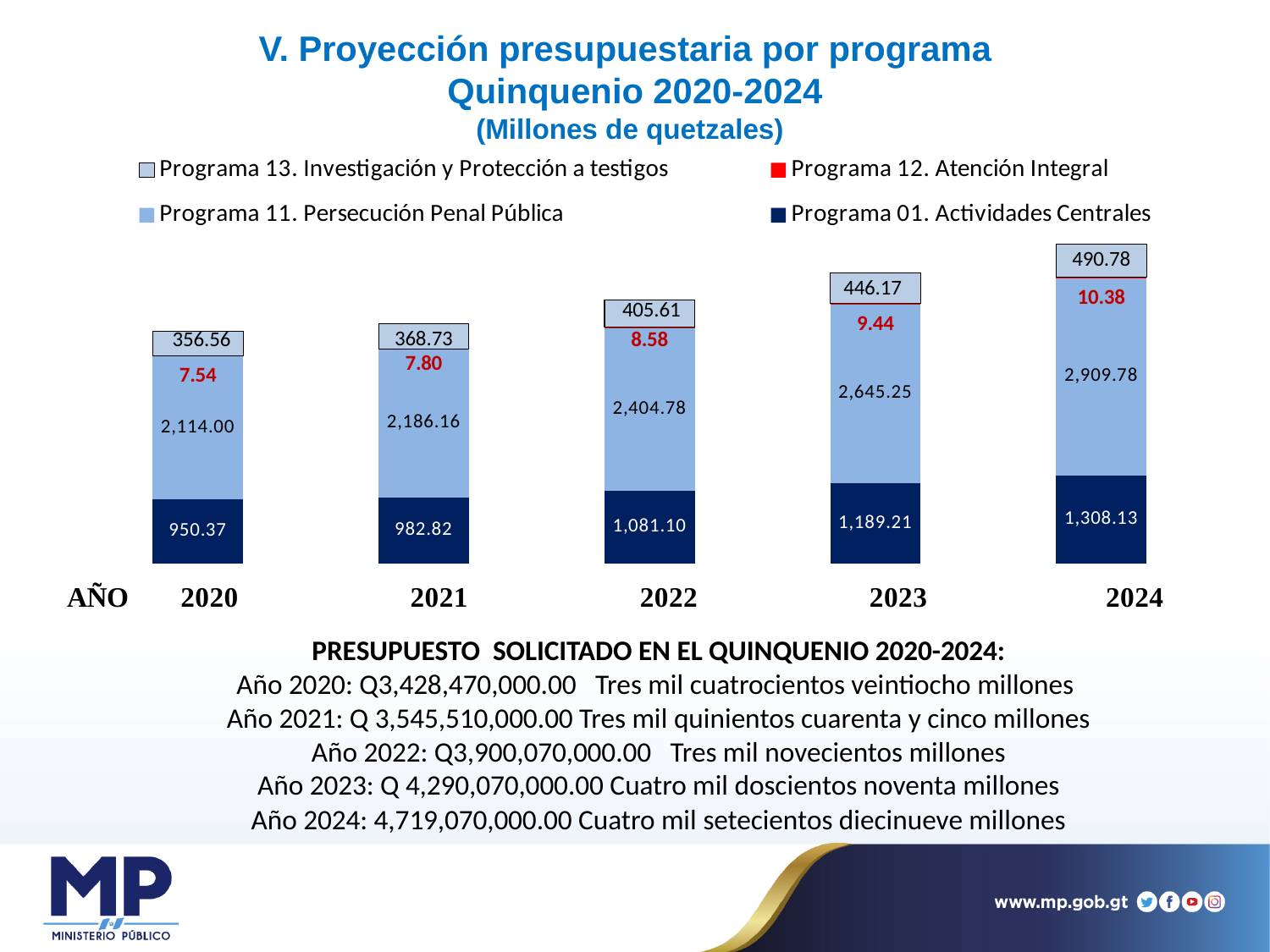
What is the value for Programa 12. Atención Integral in 2021? 7.80 What is the value for Programa 13. Investigación y Protección a testigos in 2023? 446.17 Which is larger: Programa 11. Persecución Penal Pública in 2022 or in 2023? 2023 What is the value for Programa 11. Persecución Penal Pública in 2024? 2,909.78 In which year is the value for Programa 13. Investigación y Protección a testigos the highest? 2024 Do the values for Programa 12. Atención Integral rise or fall from 2020 to 2024? Rise In which year is the value for Programa 01. Actividades Centrales the lowest? 2020 What kind of chart is shown on the slide? Stacked bar chart How many series does the legend list? 4 What is the value for Programa 01. Actividades Centrales in 2022? 1,081.10 What is the difference between the Programa 01. Actividades Centrales values for 2024 and 2020? 357.76 How many years are shown on the x axis of the chart? 5